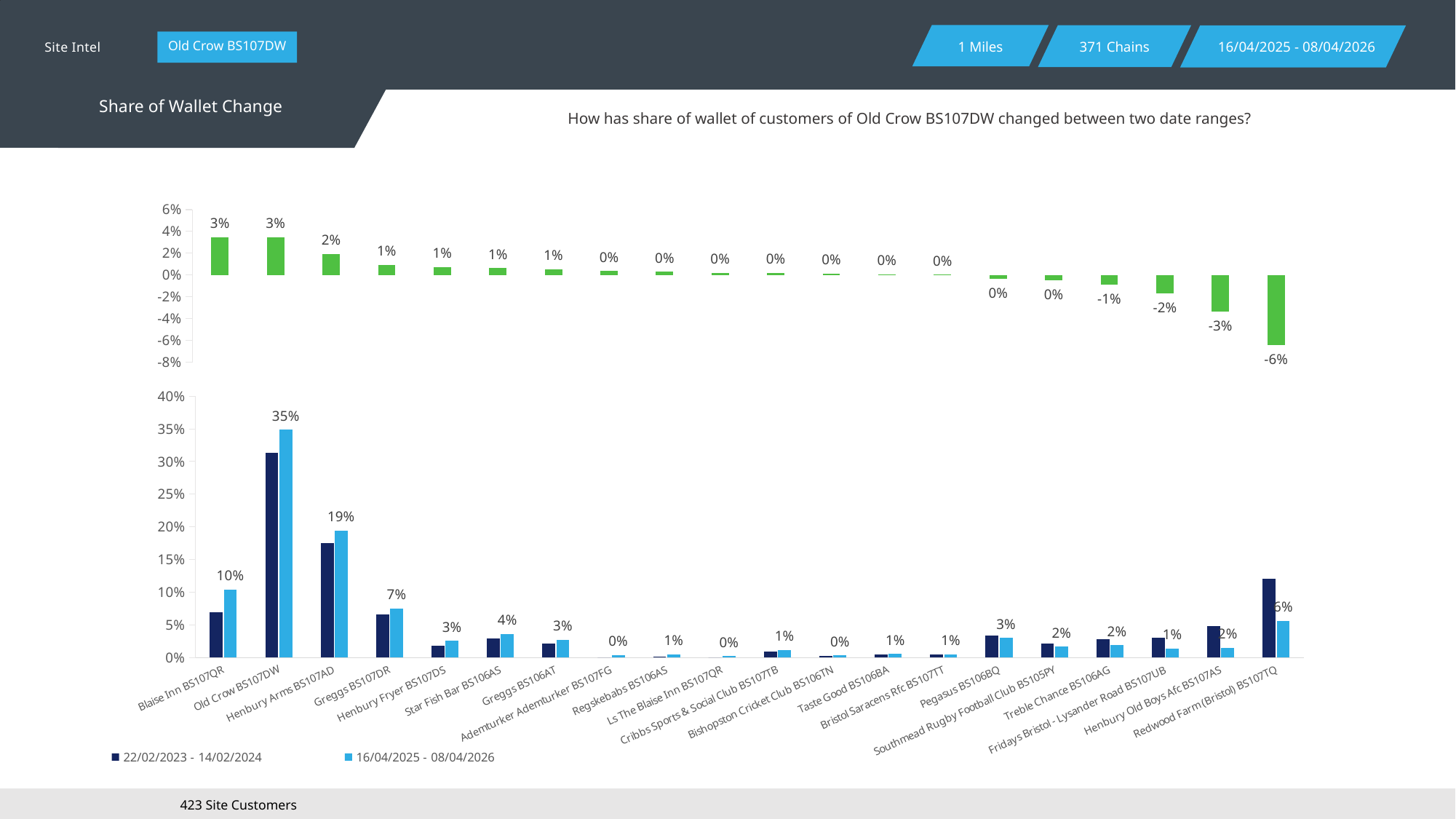
In the bottom chart, what is the share of wallet for Old Crow BS107DW in the 16/04/2025 - 08/04/2026 period? 35% In the bottom chart, which category has the highest share of wallet in the 16/04/2025 - 08/04/2026 period? Old Crow BS107DW In the top chart, what is the value for Henbury Old Boys Afc BS107AS? -3% In the bottom chart, what is the difference between Old Crow BS107DW and Henbury Arms BS107AD in the 16/04/2025 - 08/04/2026 period? 16% In the bottom chart, is the value for Old Crow BS107DW in the 22/02/2023 - 14/02/2024 period greater or less than 30%? greater In the top chart, what is the share of wallet change for Redwood Farm(Bristol) BS107TQ? -6% In the top chart, which category has the lowest share of wallet change? Redwood Farm(Bristol) BS107TQ In the bottom chart, which is larger in the 16/04/2025 - 08/04/2026 period: Blaise Inn BS107QR or Greggs BS107DR? Blaise Inn BS107QR How many categories are shown on the x axis of the bottom chart? 20 In the top chart, what is the value for Henbury Arms BS107AD? 2% What kind of chart is the bottom chart? Bar chart How many series does the legend of the bottom chart list? 2